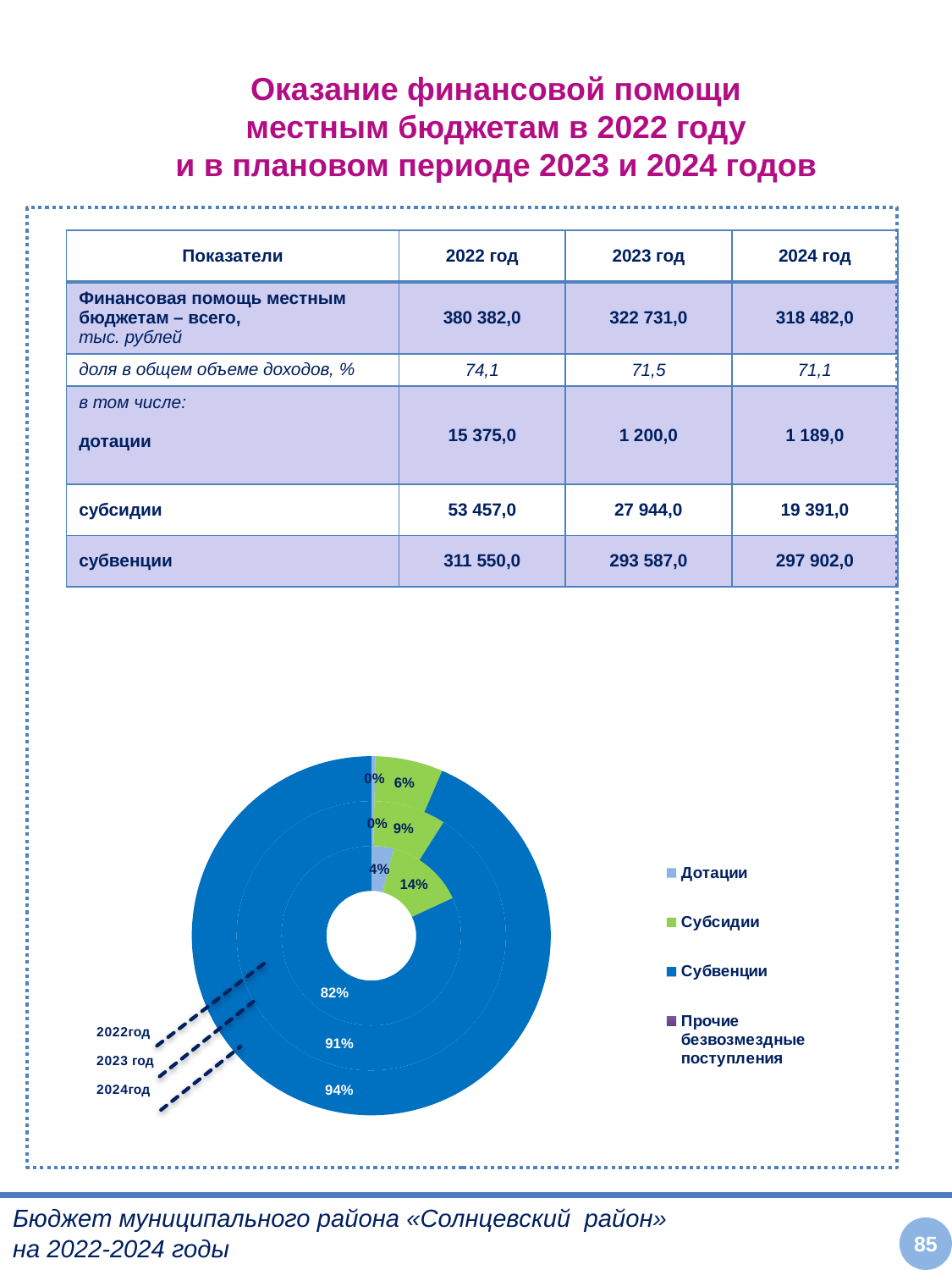
In the chart, what share do Дотации have in the 2022 ring? 4% In the chart, what share do Субсидии have in the 2022 ring? 14% In the chart, what share do Субвенции have in the 2023 ring? 91% How many series does the chart legend list? 4 In the chart, which category has the largest share in the 2024 ring? Субвенции What kind of chart is shown on the slide? doughnut chart In the chart, what share do Субсидии have in the 2024 ring? 6% In the chart, what share do Субвенции have in the 2024 ring? 94% In the chart, what share do Субвенции have in the 2022 ring? 82% In the chart, what is the difference between the Субсидии share in 2022 and in 2024? 8% In the chart, which is larger: the Субвенции share in 2022 or in 2023? 2023